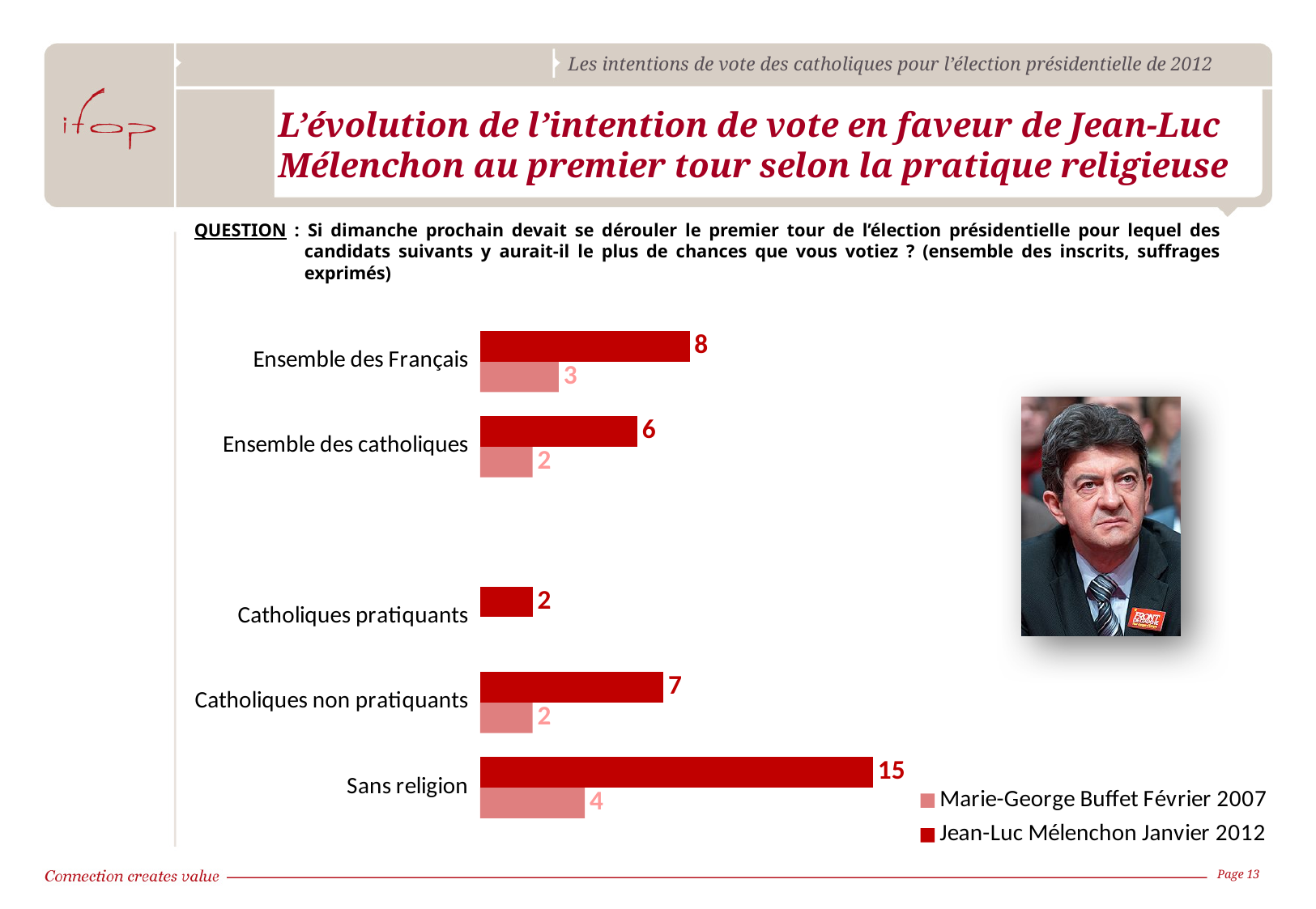
What is the value for Marie-George Buffet Février 2007 among "Ensemble des Français"? 3 What is the value for Jean-Luc Mélenchon Janvier 2012 among "Catholiques pratiquants"? 2 What kind of chart is shown on the slide? Bar chart What is the value for Jean-Luc Mélenchon Janvier 2012 among "Ensemble des catholiques"? 6 Which category has the highest value for Jean-Luc Mélenchon Janvier 2012? Sans religion How many series does the legend list? 2 Which category has the lowest value for Jean-Luc Mélenchon Janvier 2012? Catholiques pratiquants What is the value for Jean-Luc Mélenchon Janvier 2012 among "Sans religion"? 15 What is the difference between the Jean-Luc Mélenchon Janvier 2012 values for "Ensemble des Français" and "Ensemble des catholiques"? 2 How many categories are shown on the chart? 5 What is the difference between the Jean-Luc Mélenchon Janvier 2012 value and the Marie-George Buffet Février 2007 value for "Sans religion"? 11 For "Catholiques non pratiquants", which series has the larger value: Jean-Luc Mélenchon Janvier 2012 or Marie-George Buffet Février 2007? Jean-Luc Mélenchon Janvier 2012